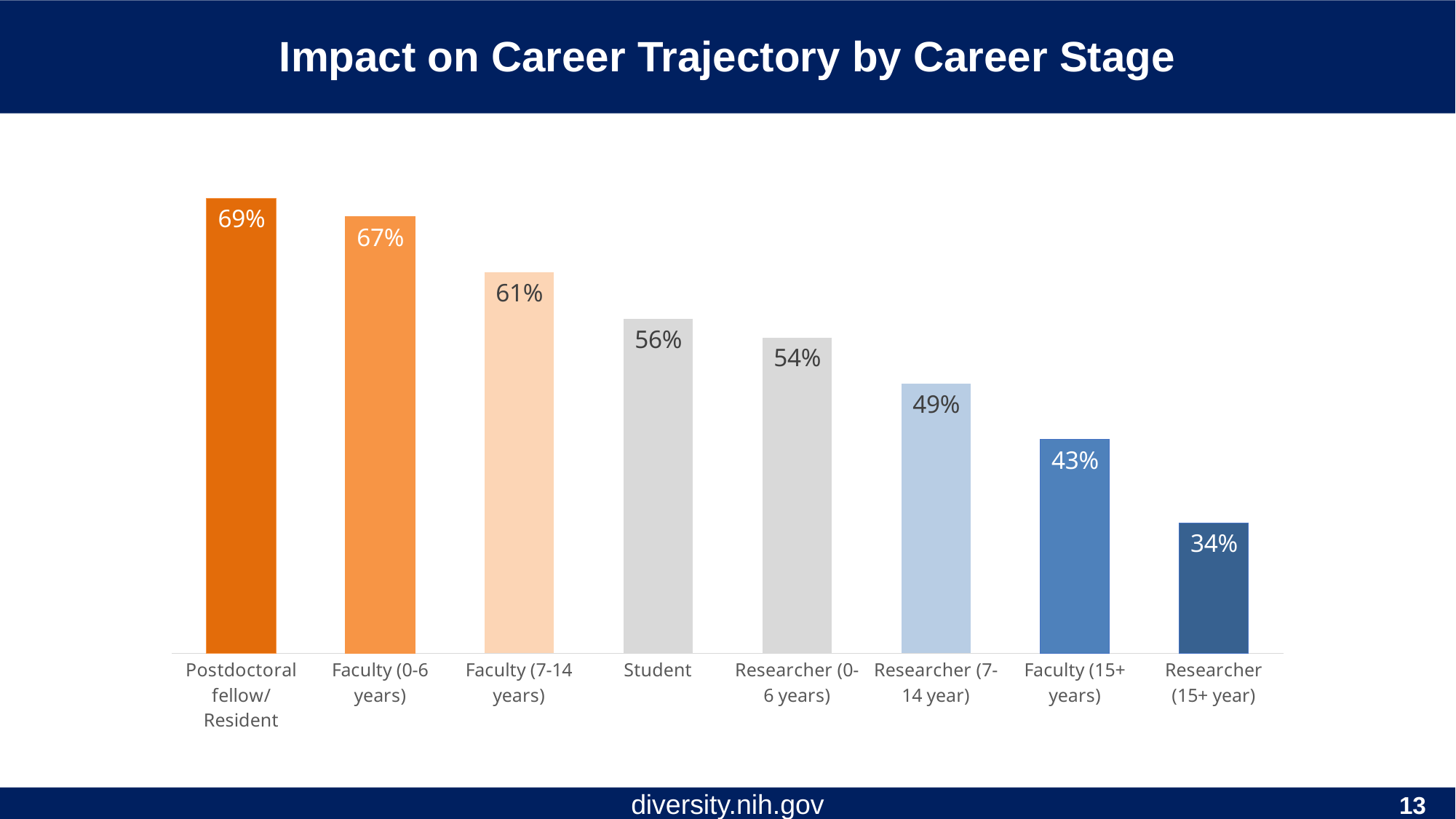
What is the value for Student? 56% What is the value for Postdoctoral fellow/Resident? 69% What kind of chart is shown on the slide? Bar chart What is the value for Researcher (7-14 year)? 49% Which is larger, the value for Student or the value for Researcher (0-6 years)? Student What is the difference between the values for Faculty (0-6 years) and Faculty (7-14 years)? 6% Which career stage has the highest value? Postdoctoral fellow/Resident Which career stage has the lowest value? Researcher (15+ year) Do the values rise or fall from left to right across the chart? Fall What is the value for Faculty (15+ years)? 43% What is the difference between the values for Postdoctoral fellow/Resident and Researcher (15+ year)? 35% How many career stages are shown in the chart? 8